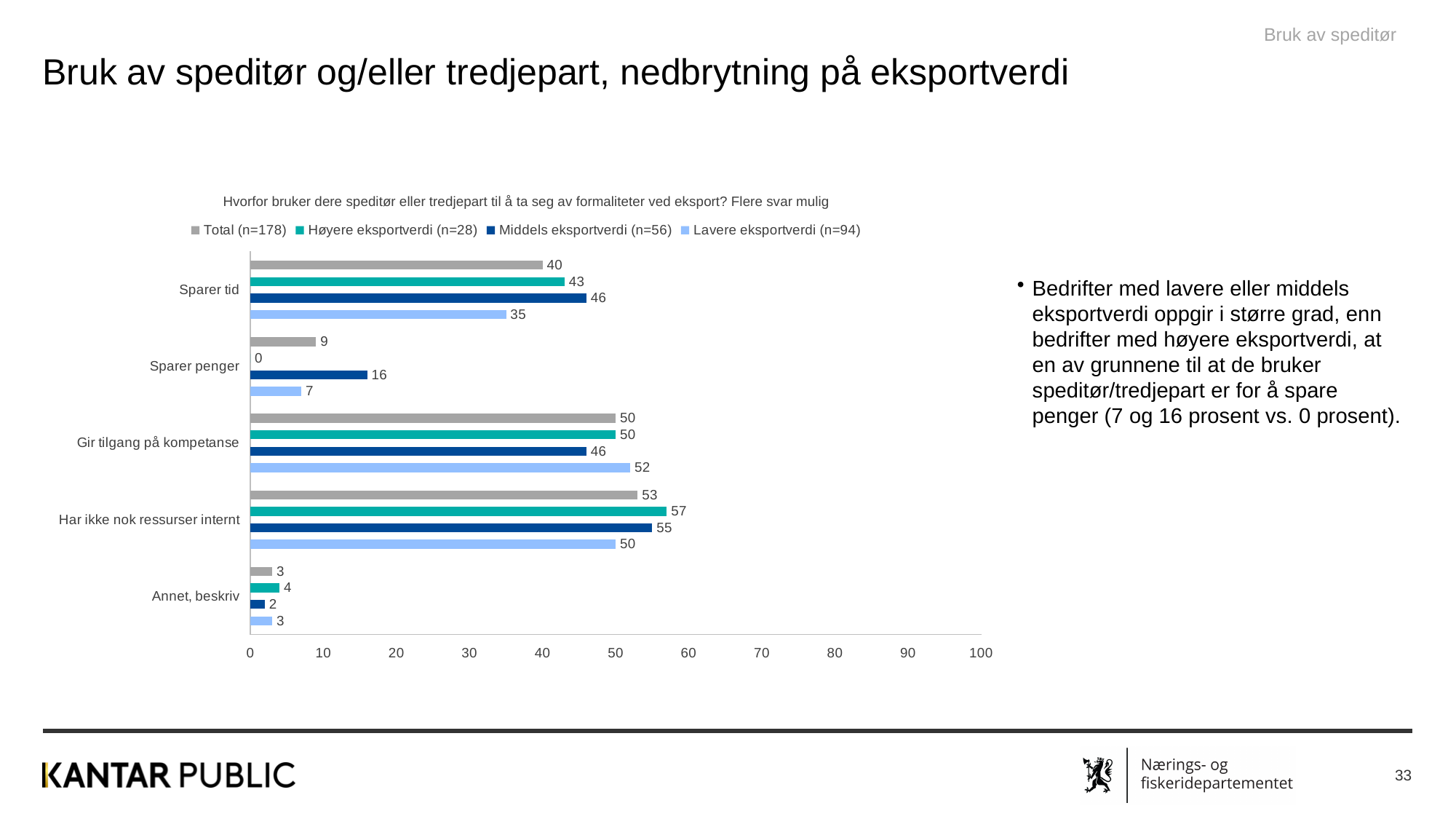
Which category has the highest value for Høyere eksportverdi (n=28)? Har ikke nok ressurser internt What is the value for Middels eksportverdi (n=56) in the 'Sparer penger' category? 16 How many categories are shown on the chart? 5 What kind of chart is shown on the slide? Bar chart What is the value for Høyere eksportverdi (n=28) in the 'Sparer penger' category? 0 For 'Har ikke nok ressurser internt', which series has the larger value: Høyere eksportverdi (n=28) or Lavere eksportverdi (n=94)? Høyere eksportverdi (n=28) What is the difference between the Middels eksportverdi (n=56) and Lavere eksportverdi (n=94) values for 'Sparer tid'? 11 Is the Total (n=178) value for 'Har ikke nok ressurser internt' greater or less than 50? greater What is the value for Lavere eksportverdi (n=94) in the 'Gir tilgang på kompetanse' category? 52 Which category has the lowest value for Total (n=178)? Annet, beskriv How many series does the legend list? 4 What is the value for Total (n=178) in the 'Sparer tid' category? 40